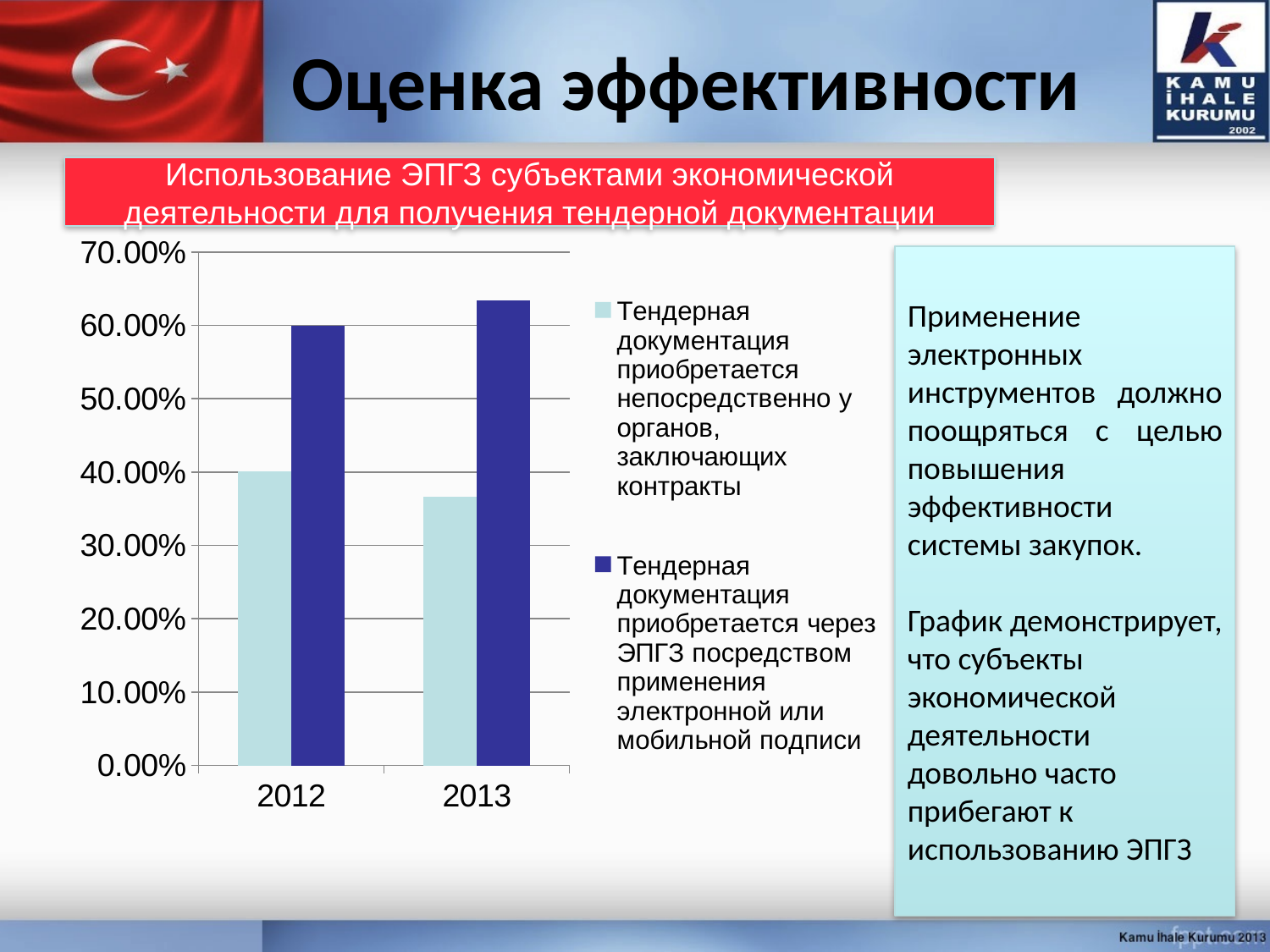
Is the 2013 value for the series 'Тендерная документация приобретается непосредственно у органов, заключающих контракты' greater or less than 40.00%? less In which year is the value for the series 'Тендерная документация приобретается через ЭПГЗ посредством применения электронной или мобильной подписи' highest? 2013 How many series does the chart's legend list? 2 Is the 2013 value for the series 'Тендерная документация приобретается через ЭПГЗ посредством применения электронной или мобильной подписи' greater or less than 60.00%? greater What kind of chart is shown on the slide? bar chart How many years (categories) are shown on the x axis of the chart? 2 Does the value for the series 'Тендерная документация приобретается через ЭПГЗ посредством применения электронной или мобильной подписи' rise or fall from 2012 to 2013? rise What is the title of the chart shown on the slide? Использование ЭПГЗ субъектами экономической деятельности для получения тендерной документации In 2013, which series has the larger value: documentation acquired directly from the contracting authorities, or documentation acquired through ЭПГЗ? Тендерная документация приобретается через ЭПГЗ посредством применения электронной или мобильной подписи Does the value for the series 'Тендерная документация приобретается непосредственно у органов, заключающих контракты' rise or fall from 2012 to 2013? fall